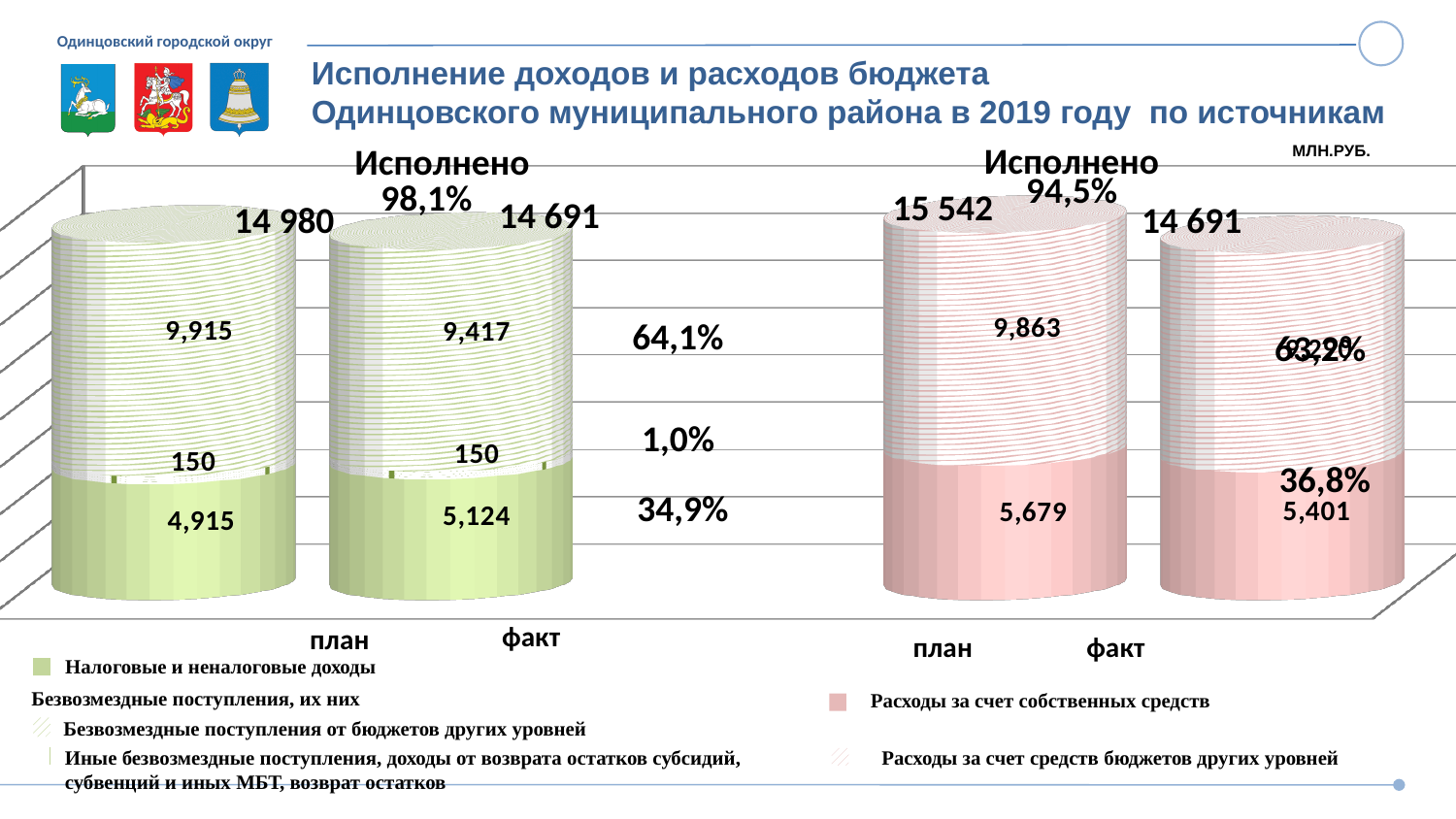
On the right chart (расходы), which bar has the larger total, план or факт? план On the left chart (доходы), what is the difference between the план and факт totals? 289 On the left chart (доходы), what is the value of the Безвозмездные поступления от бюджетов других уровней segment in the факт bar? 9,417 On the right chart (расходы), what is the total value printed above the план bar? 15 542 On the left chart (доходы), what execution percentage (Исполнено) is shown? 98,1% What kind of chart is used on this slide? stacked bar chart On the left chart (доходы), what is the total value printed above the факт bar? 14 691 On the left chart (доходы), what is the value of the Налоговые и неналоговые доходы segment in the план bar? 4,915 On the right chart (расходы), what execution percentage (Исполнено) is shown? 94,5% On the right chart (расходы), what is the value of the Расходы за счет собственных средств segment in the факт bar? 5,401 On the left chart (доходы), what is the total value printed above the план bar? 14 980 On the left chart (доходы), what is the value of the Налоговые и неналоговые доходы segment in the факт bar? 5,124